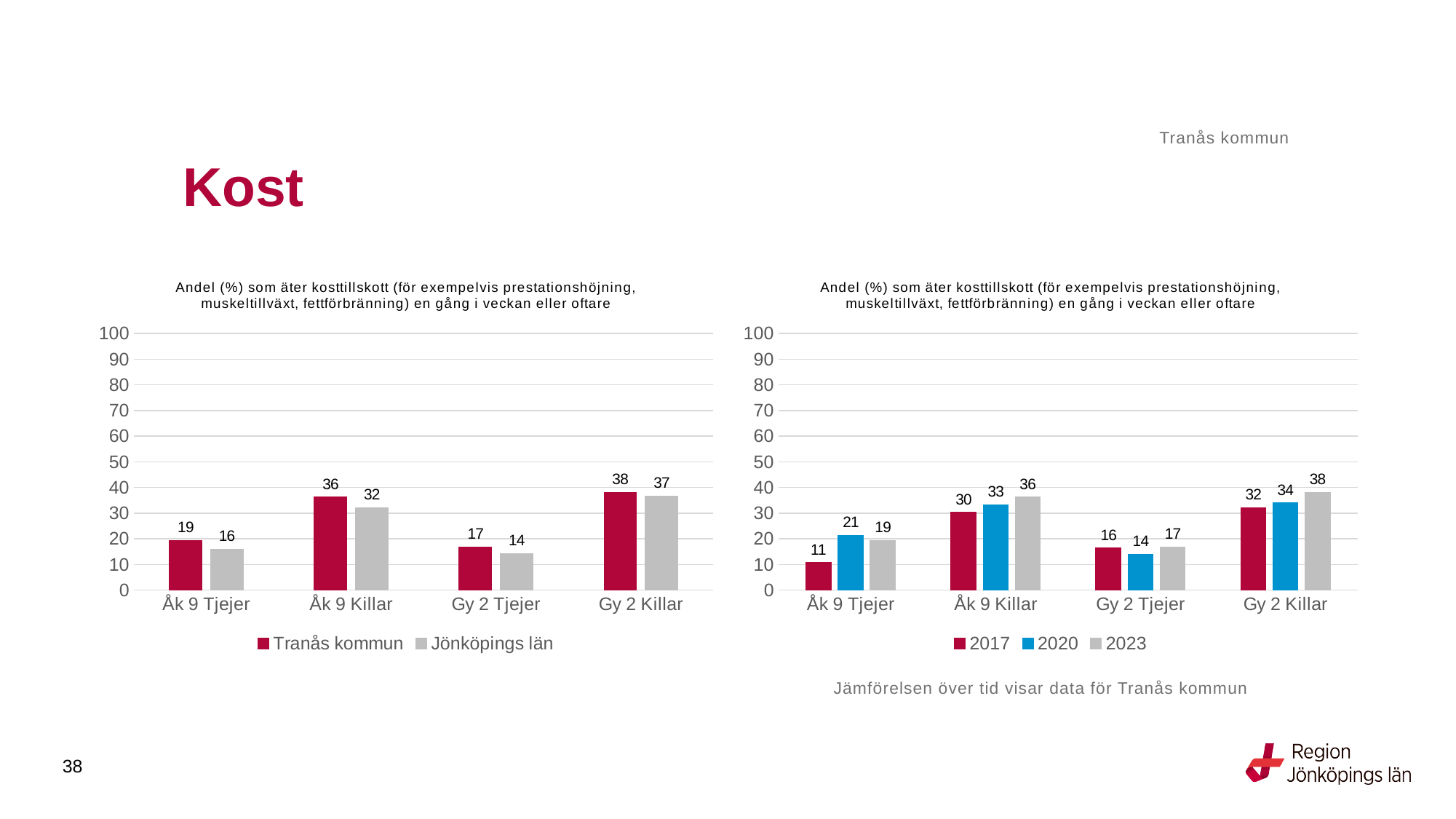
In the right chart, what is the difference between the 2023 and 2017 values for Åk 9 Killar? 6 In the left chart, which category has the highest value for Tranås kommun? Gy 2 Killar In the left chart, what is the value for Jönköpings län for Gy 2 Tjejer? 14 In the right chart, is the 2017 value for Gy 2 Tjejer larger or smaller than the 2020 value for Gy 2 Tjejer? larger In the left chart, how many series does the legend list? 2 In the left chart, what is the value for Tranås kommun for Åk 9 Killar? 36 In the left chart, what is the difference between Tranås kommun and Jönköpings län for Åk 9 Killar? 4 In the right chart, what is the value for 2023 for Gy 2 Killar? 38 In the right chart, which category has the lowest value for 2017? Åk 9 Tjejer In the right chart, what is the value for 2020 for Åk 9 Tjejer? 21 In the right chart, how many series does the legend list? 3 What kind of chart is the left chart? Bar chart